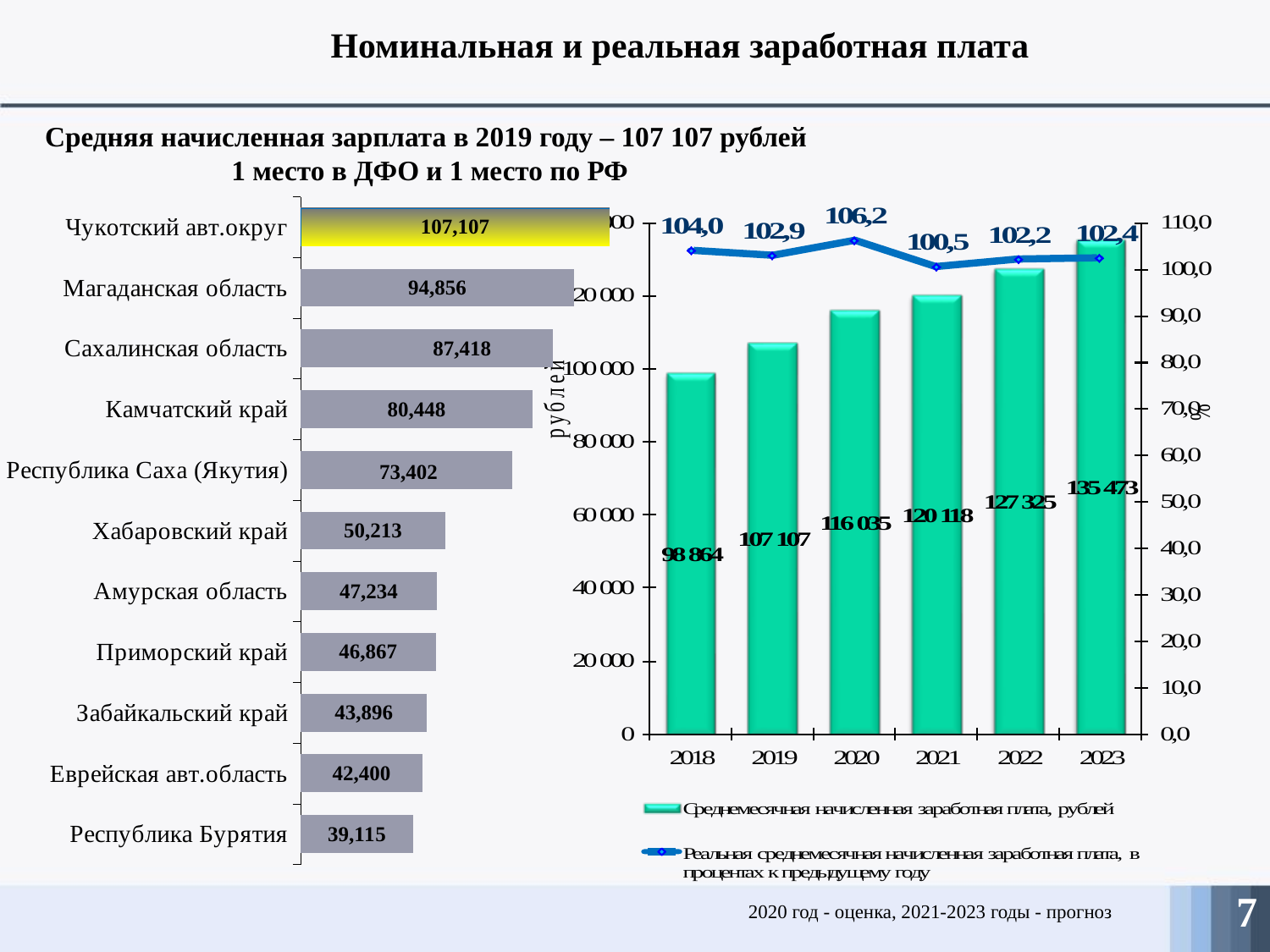
In the right chart, what is the average monthly nominal salary (bar value) for 2021? 120 118 In the left bar chart, how many regions are shown? 11 In the left bar chart, what is the difference between the values for Чукотский авт.округ and Магаданская область? 12,251 In the left bar chart, which region has the lowest value? Республика Бурятия In the left bar chart, which is larger: the value for Амурская область or Приморский край? Амурская область In the right chart, which year has the lowest real salary index (line value)? 2021 In the right chart, what is the difference between the bar values for 2023 and 2022? 8 148 How many series does the legend of the right chart list? 2 In the right chart, what is the real salary index (line value) for 2020? 106,2 In the right chart, do the bar values rise or fall from 2018 to 2023? rise In the left bar chart, what is the value for Магаданская область? 94,856 What type of chart is the left chart? bar chart